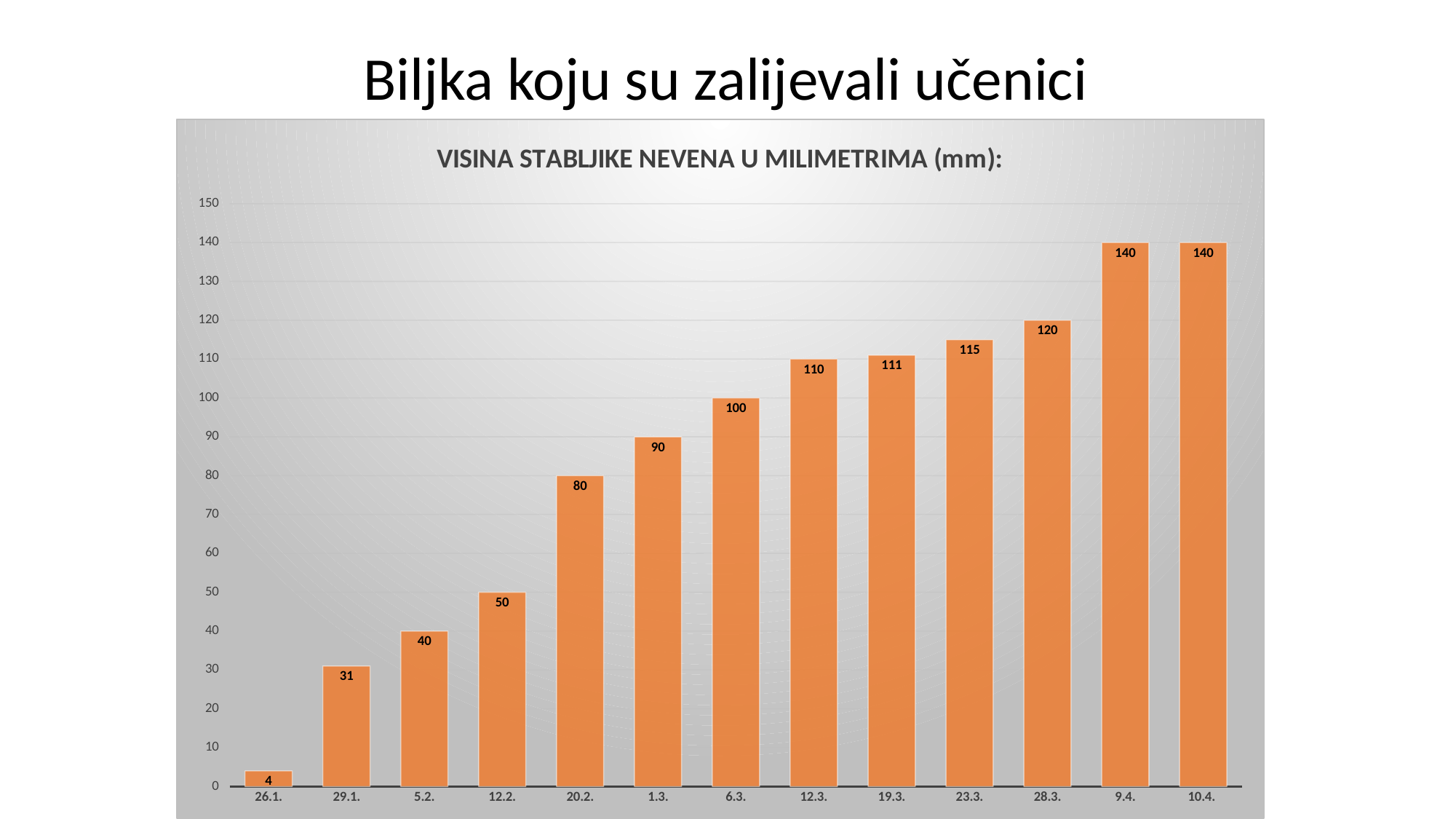
What is the difference between the values for 28.3. and 23.3.? 5 What is the title of the chart? VISINA STABLJIKE NEVENA U MILIMETRIMA (mm): Is the value for 6.3. greater or less than 90? greater How many dates are shown on the x axis? 13 Which is larger, the value for 12.2. or the value for 29.1.? 12.2. What is the value for 19.3.? 111 Which date has the lowest value? 26.1. What is the value for 20.2.? 80 Do the values rise or fall from 26.1. to 10.4.? rise What is the value for 26.1.? 4 What is the difference between the values for 9.4. and 1.3.? 50 What kind of chart is shown on the slide? bar chart